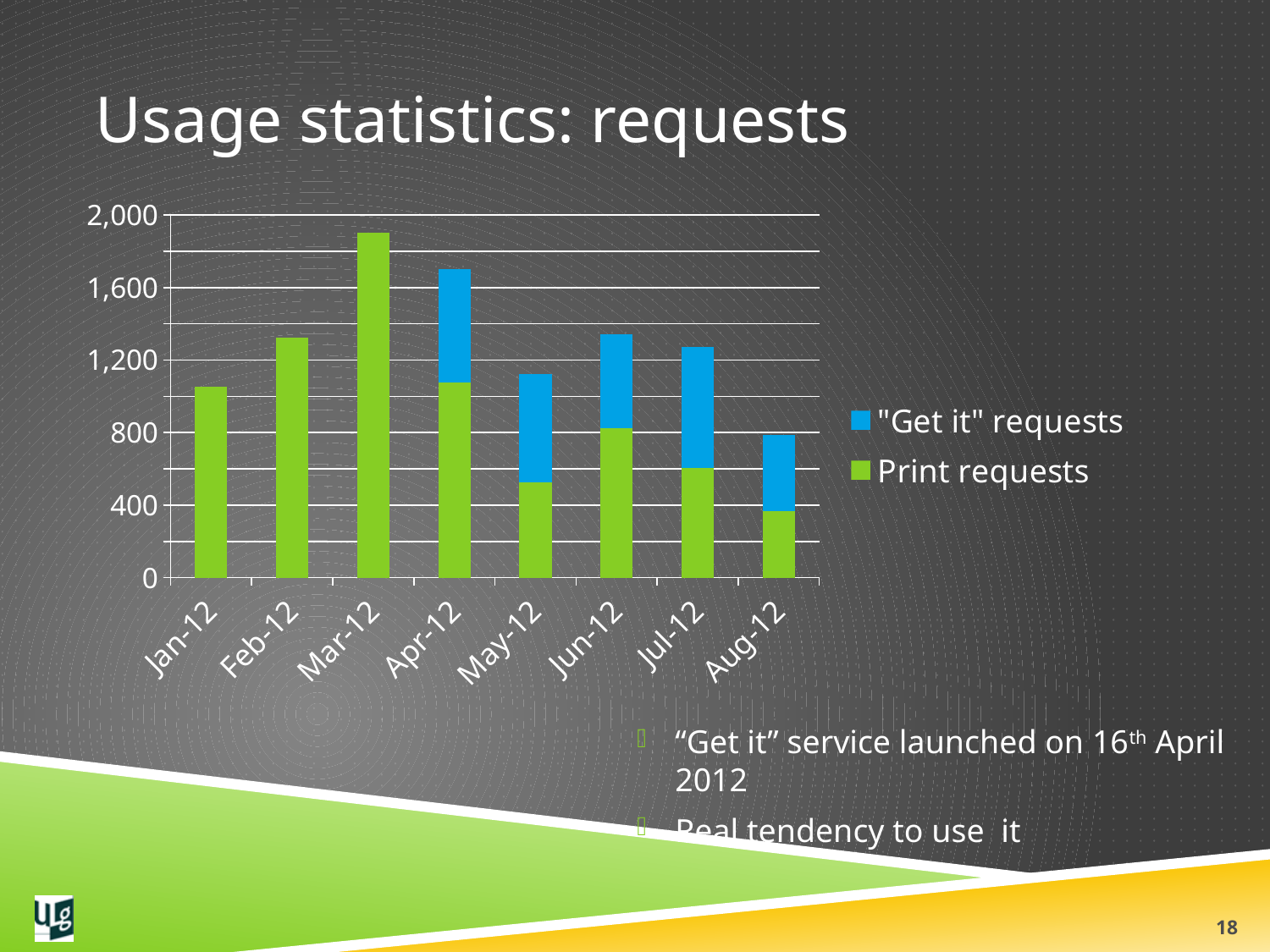
Is the total number of requests for Mar-12 greater or less than 1,600? greater Which month has more Print requests, Jan-12 or Aug-12? Jan-12 Which month has more total requests, Mar-12 or Apr-12? Mar-12 Which month has the lowest total number of requests? Aug-12 How many series does the chart legend list? 2 How many months are shown on the x axis of the chart? 8 Do the total requests rise or fall from Jun-12 to Aug-12? fall Is the total number of requests for Aug-12 greater or less than 1,200? less Which month has the highest total number of requests? Mar-12 Which colour represents "Get it" requests in the chart? Blue Is the number of Print requests for May-12 greater or less than 800? less What kind of chart is shown on the slide? Stacked bar chart